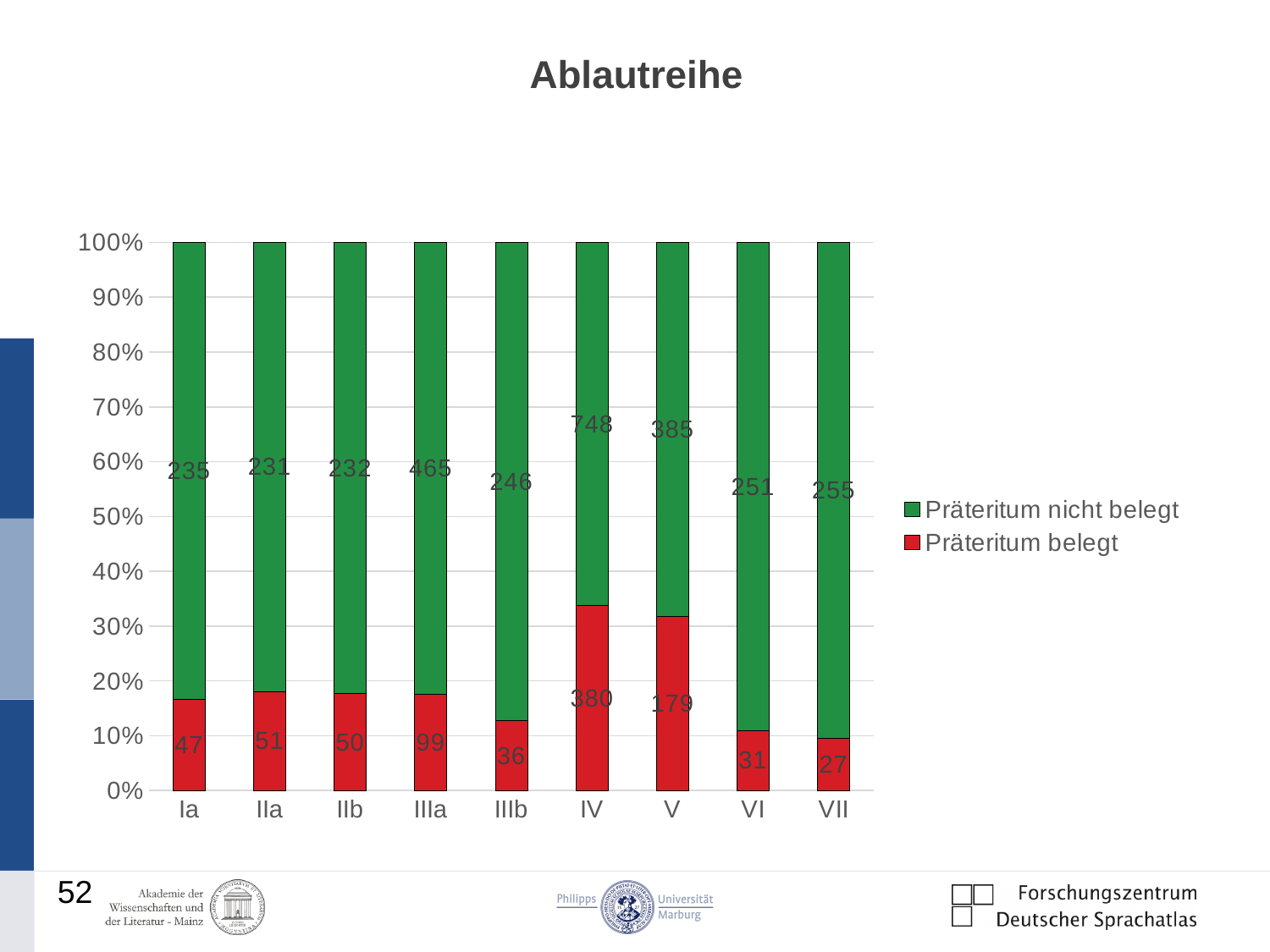
How many series does the legend list? 2 What is the difference between the "Präteritum belegt" values for IV and V? 201 Which is larger: the "Präteritum nicht belegt" value for IIa or for IIb? IIb What is the total of the two labelled values in the bar for Ia? 282 Which category has the lowest value for "Präteritum belegt"? VII What is the value of "Präteritum belegt" for category IV? 380 Which category has the highest value for "Präteritum nicht belegt"? IV How many categories are shown on the x axis? 9 Is the share of "Präteritum belegt" in the bar for IV greater or less than 30%? greater What is the value of "Präteritum nicht belegt" for category IIIa? 465 What kind of chart is shown on the slide? Stacked bar chart Is the share of "Präteritum belegt" in the bar for Ia greater or less than 20%? less